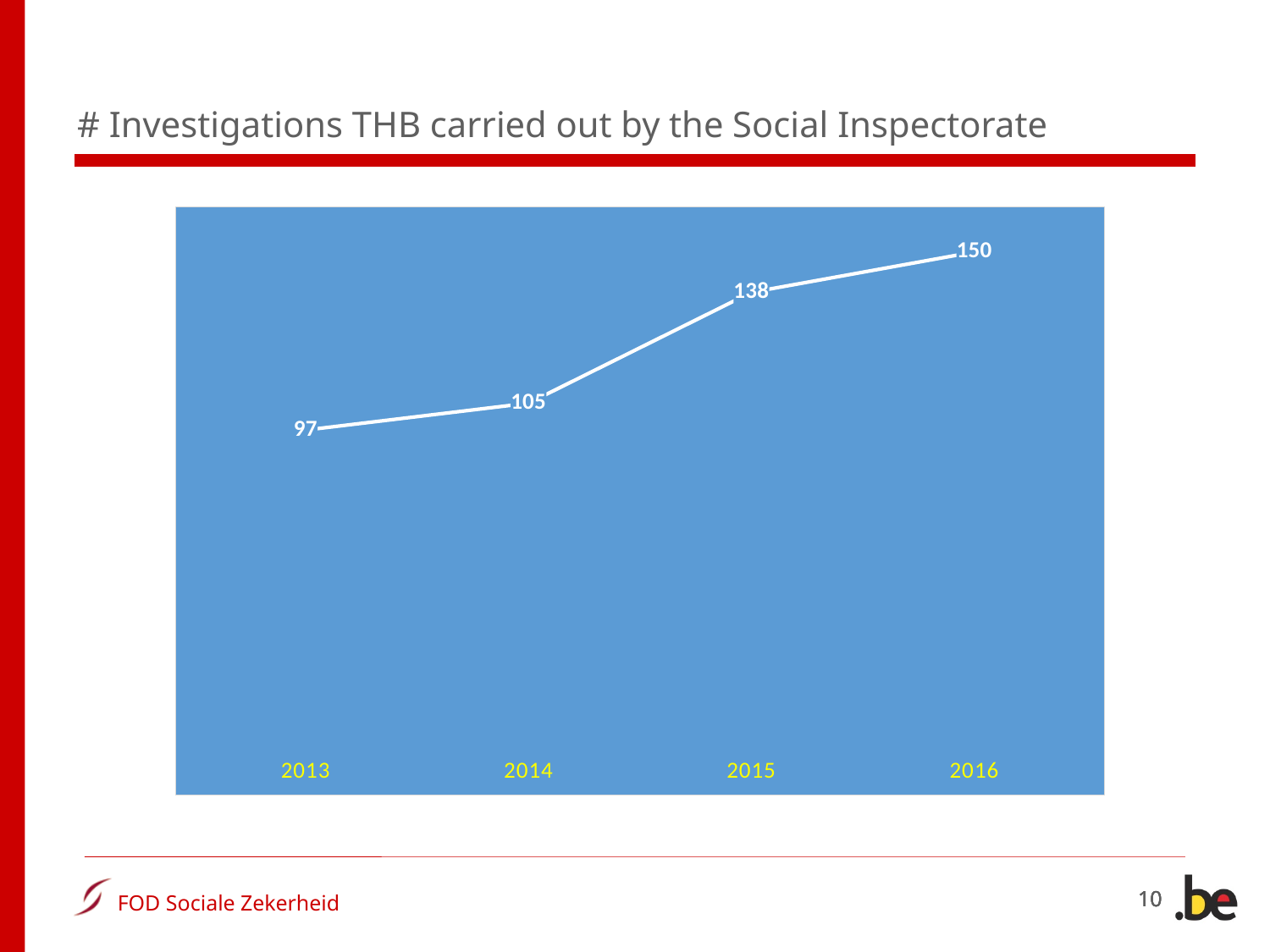
Which year has the lowest number of THB investigations? 2013 What kind of chart is shown on the slide? Line chart What is the number of THB investigations carried out by the Social Inspectorate in 2013? 97 What is the difference between the number of investigations in 2016 and in 2013? 53 What is the number of THB investigations carried out by the Social Inspectorate in 2014? 105 Do the number of THB investigations rise or fall from 2013 to 2016? Rise How many years are plotted on the chart? 4 What is the number of THB investigations carried out by the Social Inspectorate in 2016? 150 Which year has the highest number of THB investigations? 2016 What is the number of THB investigations carried out by the Social Inspectorate in 2015? 138 What is the difference between the number of investigations in 2015 and in 2014? 33 Which year had more THB investigations, 2014 or 2015? 2015